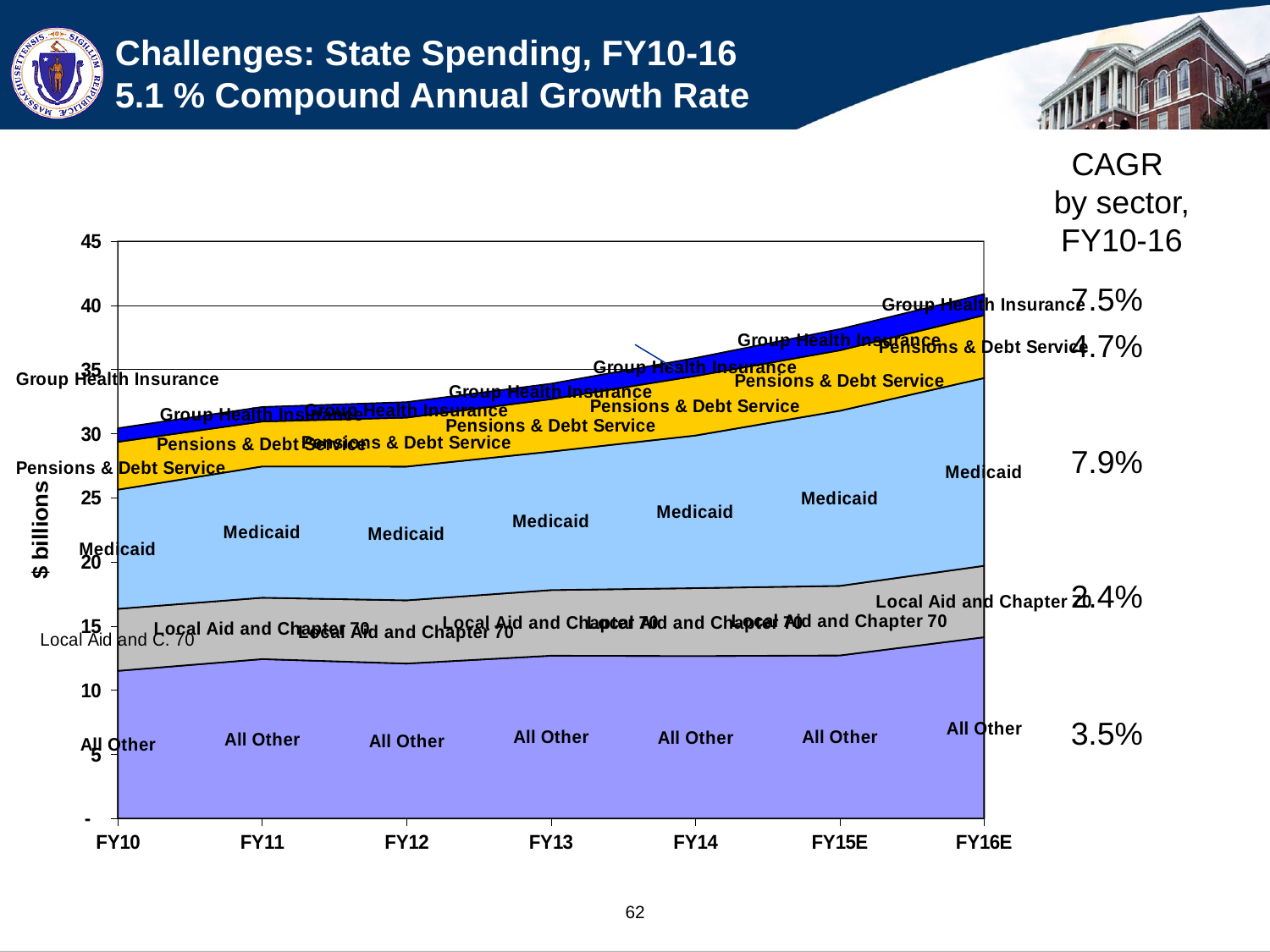
Is total state spending in FY10 greater or less than 35 $ billions? less What is the CAGR by sector for Local Aid and Chapter 70, FY10-16, as annotated on the slide? 2.4% Which sector has the highest CAGR for FY10-16 according to the annotations? Medicaid How many fiscal years are shown along the x axis of the chart? 7 What unit is shown on the y axis of the chart? $ billions What kind of chart is shown on the slide? Stacked area chart What is the CAGR by sector for All Other, FY10-16, as annotated on the slide? 3.5% What is the CAGR by sector for Medicaid, FY10-16, as annotated on the slide? 7.9% What is the CAGR by sector for Group Health Insurance, FY10-16, as annotated on the slide? 7.5% What is the CAGR by sector for Pensions & Debt Service, FY10-16, as annotated on the slide? 4.7% Does total state spending rise or fall from FY10 to FY16E? Rise How many spending sectors are stacked in the chart? 5